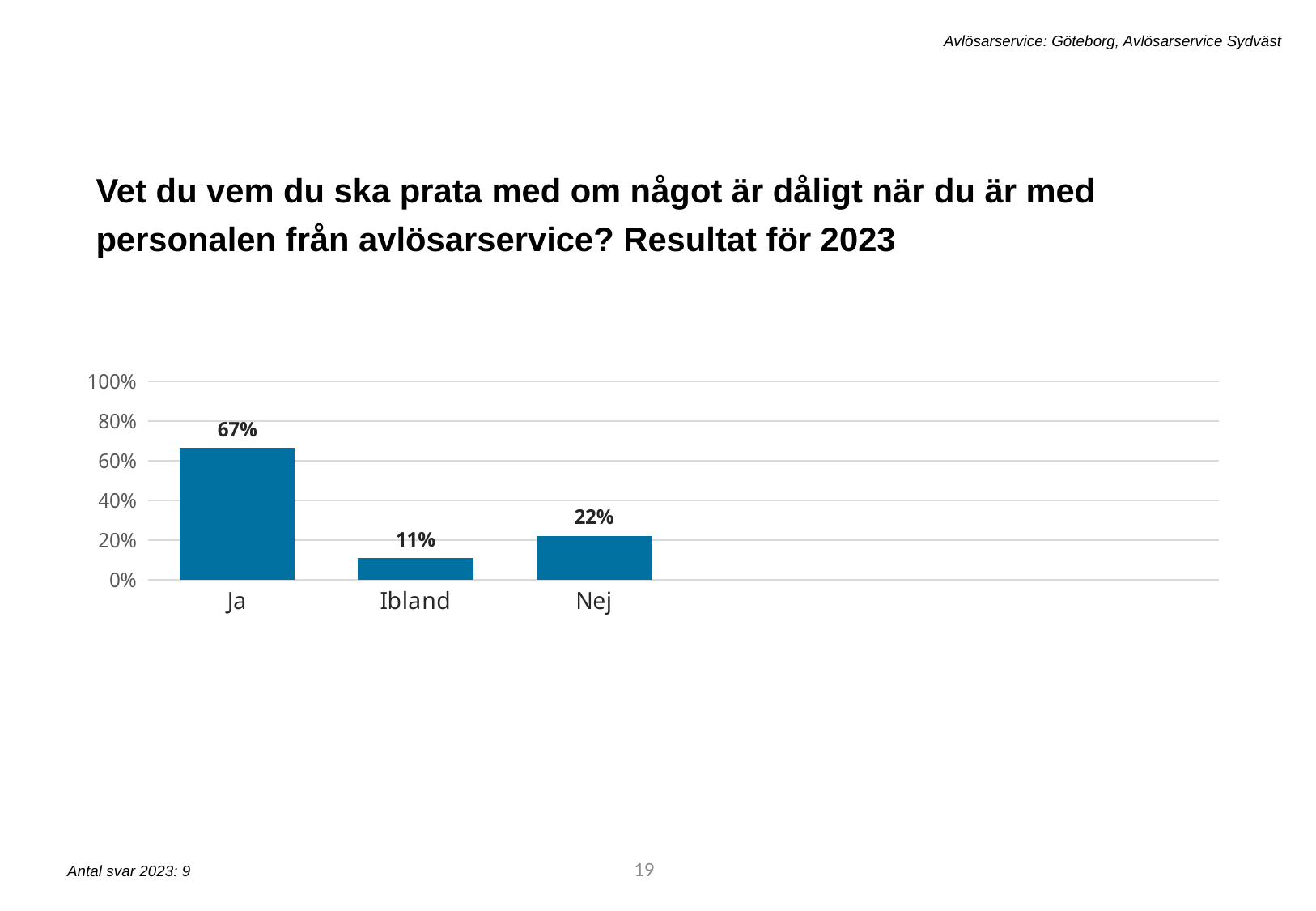
What is the value for "Ibland"? 11% What is the difference between the values for "Ja" and "Nej"? 45% Which category has the highest value? Ja Is the value for "Ja" greater or less than 60%? greater Which is larger, the value for "Nej" or the value for "Ibland"? Nej What is the value for "Nej"? 22% Which category has the lowest value? Ibland What is the highest value shown on the y axis? 100% How many categories are shown on the x axis? 3 What is the value for "Ja"? 67% What is the difference between the values for "Nej" and "Ibland"? 11% What kind of chart is shown on the slide? bar chart